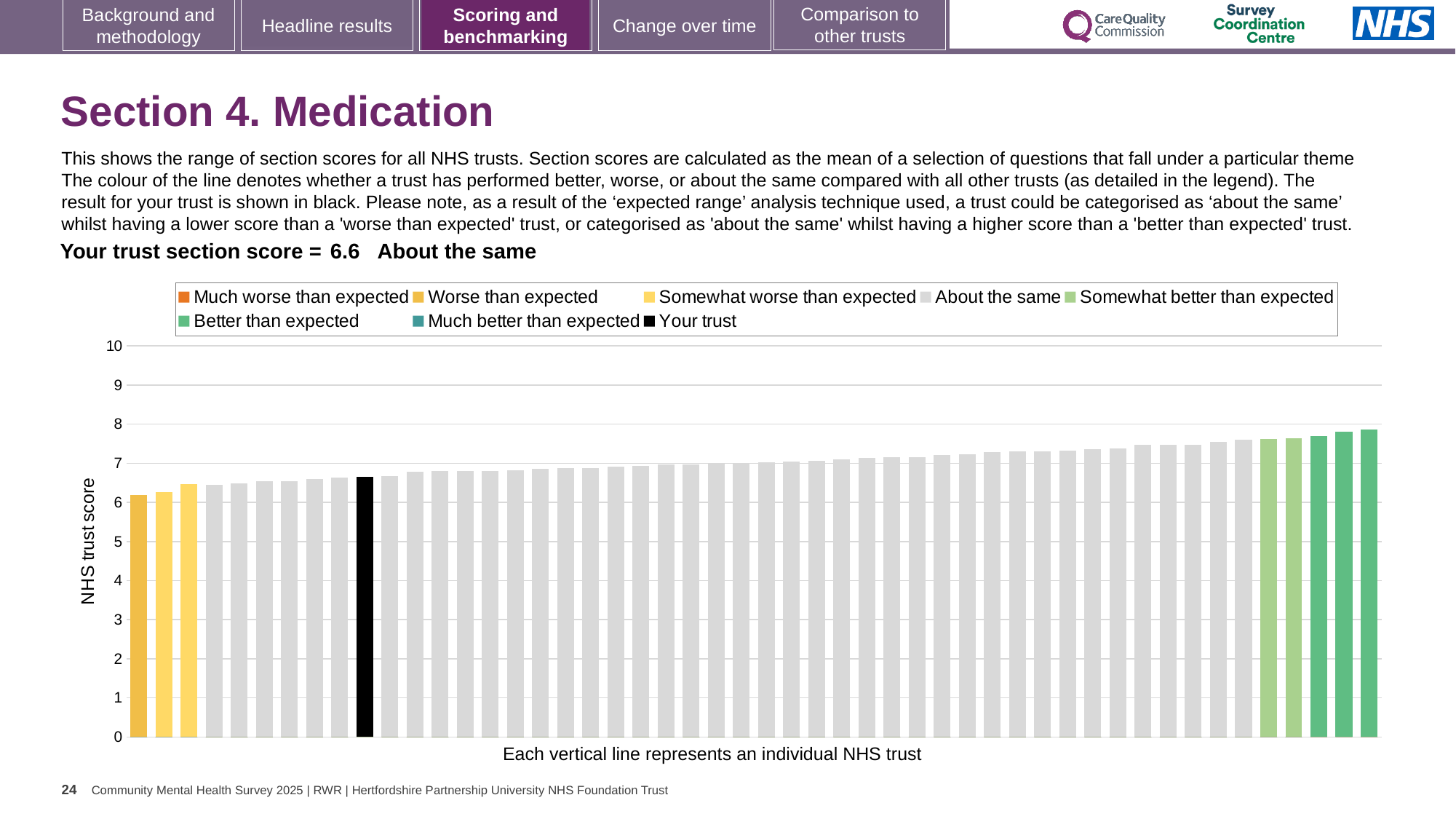
What is the label on the vertical axis of the chart? NHS trust score Is the value of the tallest bar in the chart greater or less than 8? less Do the bar values rise or fall from left to right across the chart? rise How many bars are coloured as 'Somewhat better than expected' in the chart? 2 Is the value of the tallest bar in the chart greater or less than 7? greater How many bars are coloured as 'Worse than expected' in the chart? 1 Is the value of the shortest bar in the chart greater or less than 6? greater How many entries does the chart legend list? 8 Which category is your trust's section score placed in? About the same How many bars are coloured as 'Better than expected' in the chart? 3 What kind of chart is shown on the slide? Bar chart What is the section score for your trust shown on the slide? 6.6